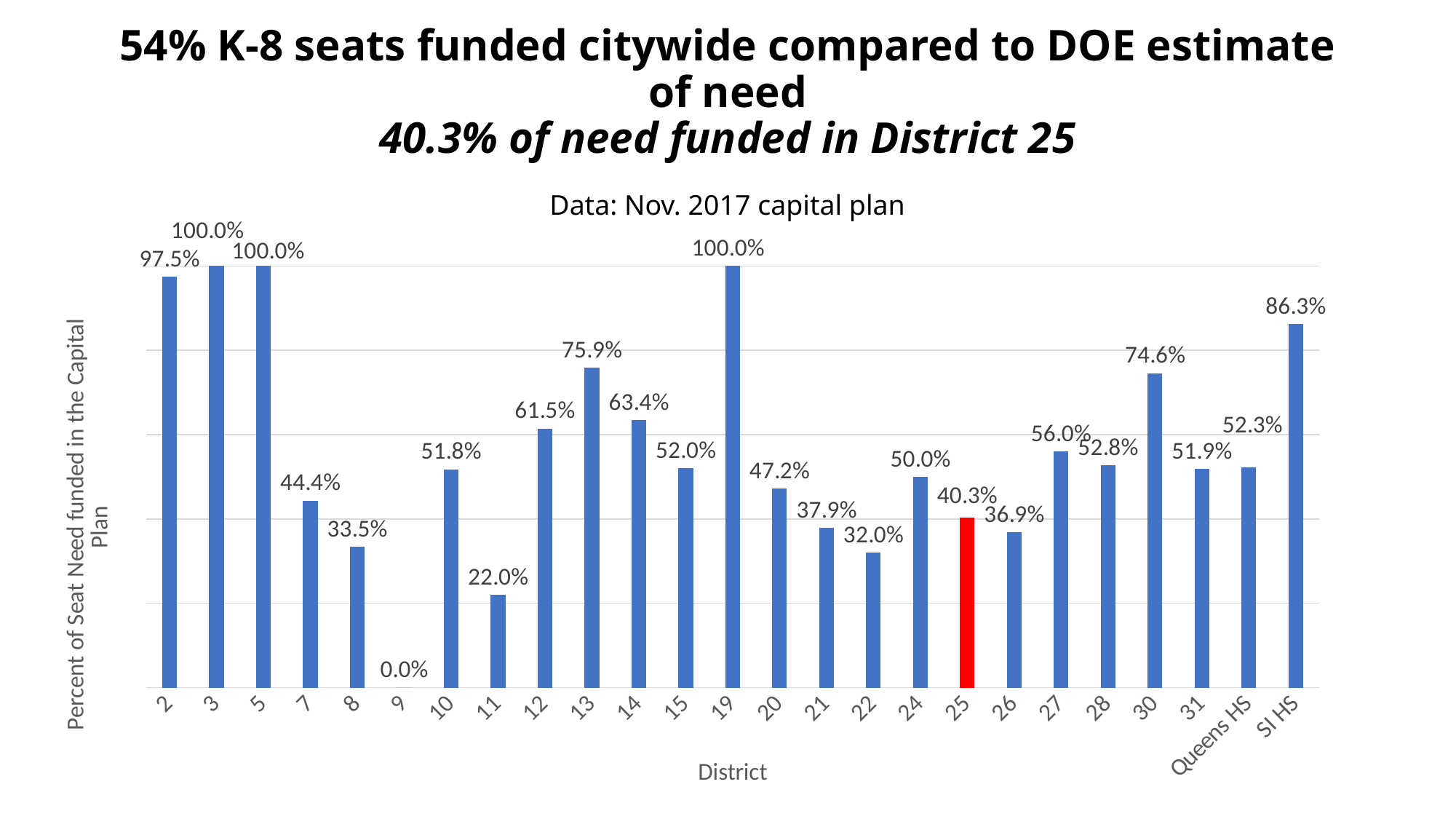
What percent of seat need is funded in the capital plan for District 25? 40.3% What percent of seat need is funded for SI HS? 86.3% How many districts or categories are shown on the x axis? 25 What is the difference in percentage points between District 2 and District 11? 75.5 What data source is cited below the title? Nov. 2017 capital plan Which district's bar is coloured red? 25 What is the difference in percentage points between District 13 and District 25? 35.6 What type of chart is shown on the slide? Bar chart What is the value shown for District 13? 75.9% What is the value shown for Queens HS? 52.3% Which has a higher percent of seat need funded, District 12 or District 20? District 12 Which district has the lowest percent of seat need funded? 9